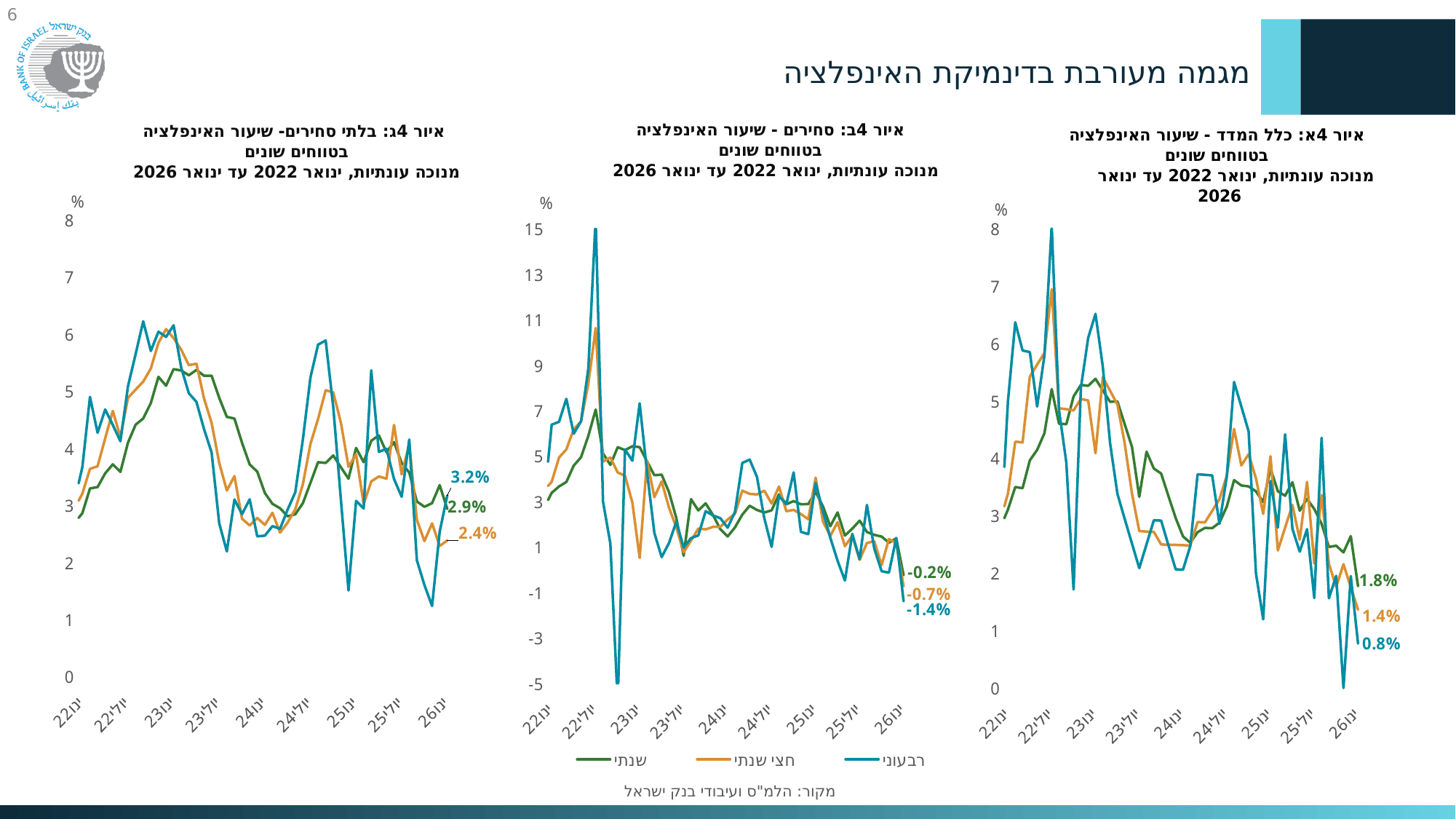
What kind of chart is the chart titled 'איור 4א: כלל המדד' (right chart)? Line chart In the chart titled 'איור 4ב: סחירים' (middle chart), which final labelled value is larger: the שנתי series or the רבעוני series? שנתי In the chart titled 'איור 4ב: סחירים' (middle chart), which series has the lowest final labelled value? רבעוני In the chart titled 'איור 4א: כלל המדד' (right chart), what is the final labelled value of the רבעוני (quarterly) series? 0.8% In the chart titled 'איור 4א: כלל המדד' (right chart), what is the final labelled value of the שנתי (annual) series? 1.8% In the chart titled 'איור 4ג: בלתי סחירים' (left chart), what is the difference between the final labelled values of the רבעוני series (3.2%) and the חצי שנתי series (2.4%)? 0.8% In the chart titled 'איור 4ב: סחירים' (middle chart), what is the final labelled value of the חצי שנתי (semi-annual) series? -0.7% How many series does the legend list for the charts on the slide? 3 In the chart titled 'איור 4א: כלל המדד' (right chart), what is the difference between the final labelled values of the שנתי series (1.8%) and the חצי שנתי series (1.4%)? 0.4% In the chart titled 'איור 4ג: בלתי סחירים' (left chart), what is the final labelled value of the רבעוני (quarterly) series? 3.2% In the chart titled 'איור 4א: כלל המדד' (right chart), does the שנתי (annual) series generally rise or fall from 2023 to January 2026? Fall In the chart titled 'איור 4ג: בלתי סחירים' (left chart), which series has the highest final labelled value? רבעוני